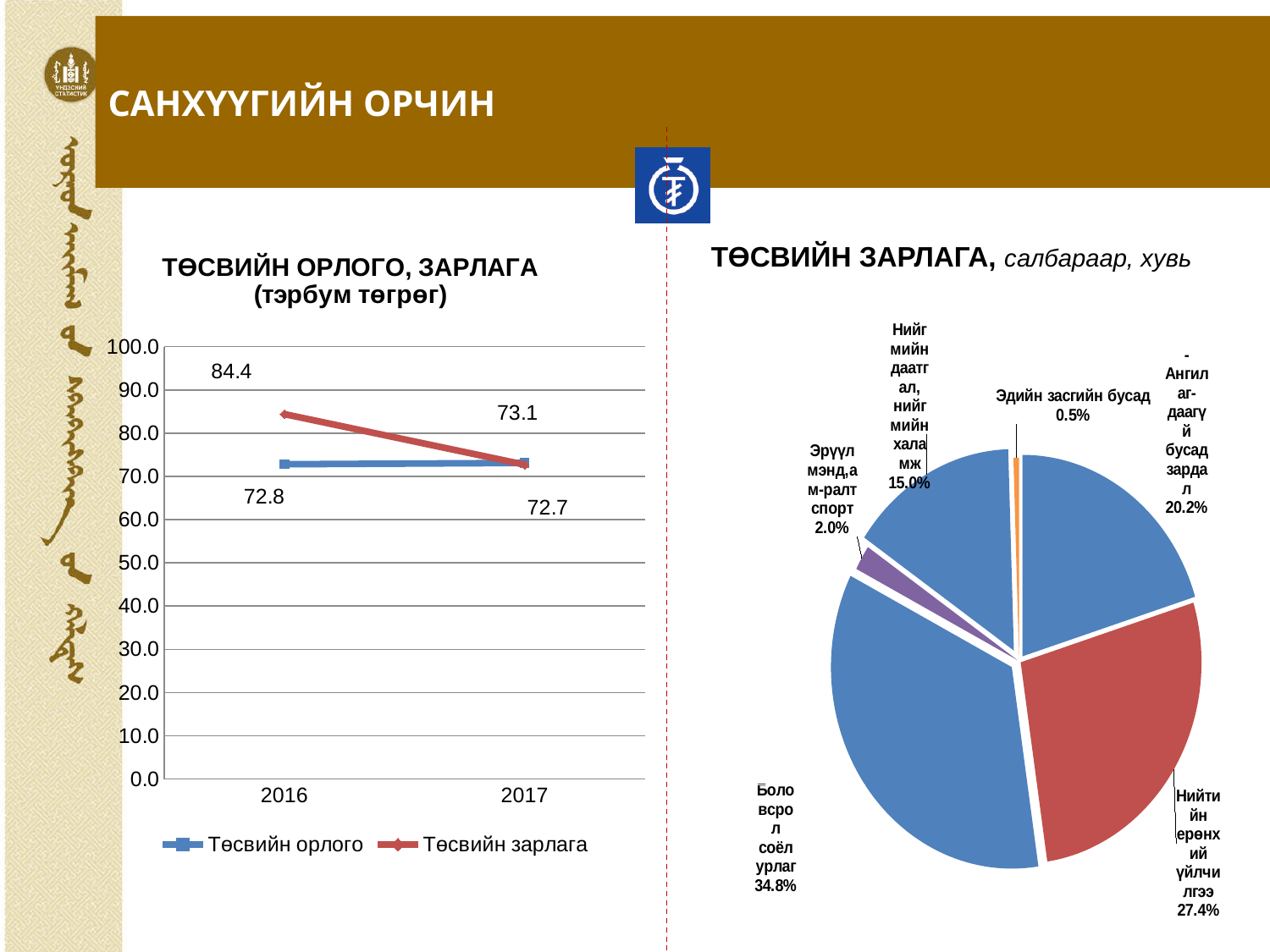
In the line chart 'ТӨСВИЙН ОРЛОГО, ЗАРЛАГА', what is the value of Төсвийн орлого in 2017? 73.1 In the line chart 'ТӨСВИЙН ОРЛОГО, ЗАРЛАГА', what is the value of Төсвийн зарлага in 2016? 84.4 In the pie chart 'ТӨСВИЙН ЗАРЛАГА, салбараар, хувь', which slice is the smallest? Эдийн засгийн бусад What kind of chart is 'ТӨСВИЙН ОРЛОГО, ЗАРЛАГА'? line chart How many slices does the pie chart 'ТӨСВИЙН ЗАРЛАГА, салбараар, хувь' have? 6 In the line chart 'ТӨСВИЙН ОРЛОГО, ЗАРЛАГА', which is larger in 2016: Төсвийн орлого or Төсвийн зарлага? Төсвийн зарлага In the line chart 'ТӨСВИЙН ОРЛОГО, ЗАРЛАГА', does Төсвийн зарлага rise or fall from 2016 to 2017? fall In the pie chart 'ТӨСВИЙН ЗАРЛАГА, салбараар, хувь', what is the share of Нийтийн ерөнхий үйлчилгээ? 27.4% In the pie chart 'ТӨСВИЙН ЗАРЛАГА, салбараар, хувь', what share does Боловсрол соёл урлаг have? 34.8% In the pie chart 'ТӨСВИЙН ЗАРЛАГА, салбараар, хувь', which slice is the largest? Боловсрол соёл урлаг In the line chart 'ТӨСВИЙН ОРЛОГО, ЗАРЛАГА', what is the difference between Төсвийн зарлага in 2016 and in 2017? 11.7 How many series does the legend of the line chart 'ТӨСВИЙН ОРЛОГО, ЗАРЛАГА' list? 2